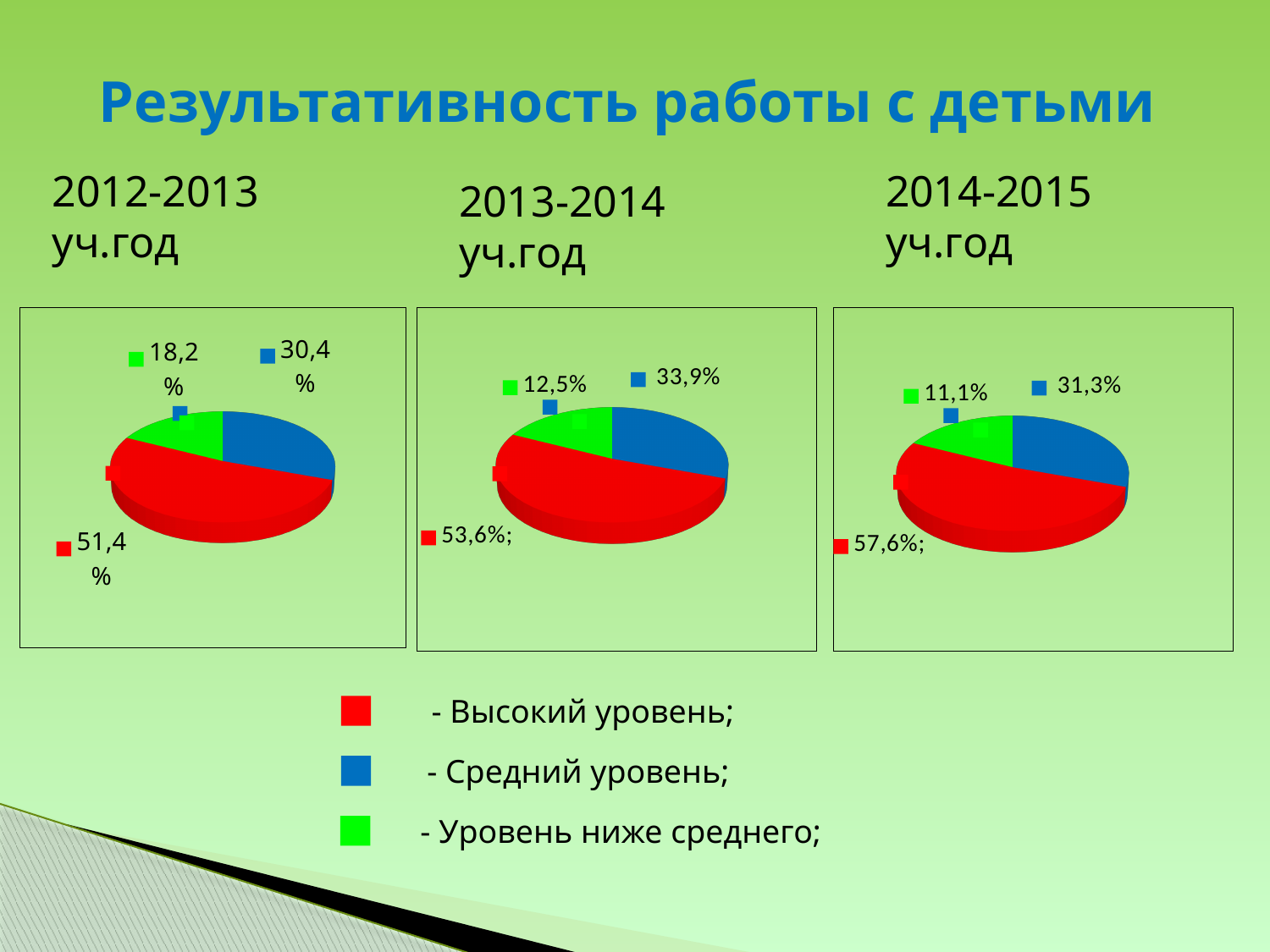
In the 2012-2013 уч.год pie chart, what share is shown for the red slice (Высокий уровень)? 51,4% In the 2014-2015 уч.год pie chart, what share is shown for the red slice (Высокий уровень)? 57,6% In the 2014-2015 уч.год pie chart, what share is shown for the green slice (Уровень ниже среднего)? 11,1% In the 2013-2014 уч.год pie chart, what share is shown for the blue slice (Средний уровень)? 33,9% Which is larger: the Средний уровень share in 2013-2014 or in 2014-2015? 2013-2014 In the 2013-2014 уч.год pie chart, which level has the largest share? Высокий уровень What is the difference between the Высокий уровень share in 2014-2015 (57,6%) and in 2012-2013 (51,4%)? 6,2% Does the Уровень ниже среднего share rise or fall from 2012-2013 to 2014-2015? Fall According to the legend at the bottom of the slide, which level does the blue colour represent? Средний уровень In the 2012-2013 уч.год pie chart, which level has the smallest share? Уровень ниже среднего How many slices does each pie chart on the slide have? 3 What type of chart is used for each of the three school years on the slide? Pie chart